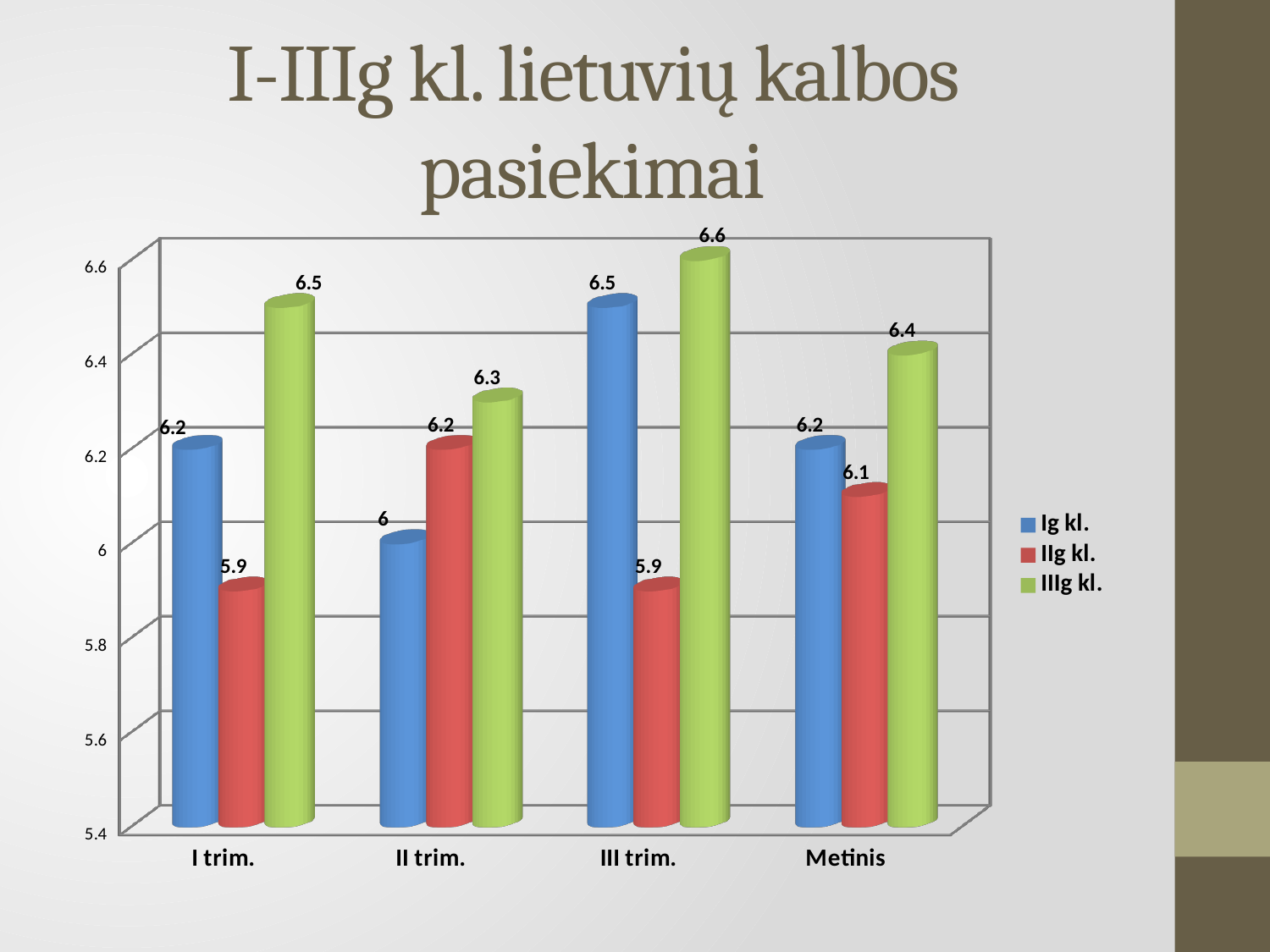
What is the difference between IIIg kl. and IIg kl. in III trim.? 0.7 What is the value for Ig kl. in II trim.? 6 How many series does the legend list? 3 In which category does IIIg kl. reach its highest value? III trim. What is the value for Ig kl. in I trim.? 6.2 What is the value for IIIg kl. in Metinis? 6.4 How many categories are shown on the x axis? 4 What is the value for IIg kl. in III trim.? 5.9 What is the title of the slide? I-IIIg kl. lietuvių kalbos pasiekimai In which category does Ig kl. have its lowest value? II trim. Which is larger in II trim., Ig kl. or IIg kl.? IIg kl. What kind of chart is shown on the slide? Bar chart